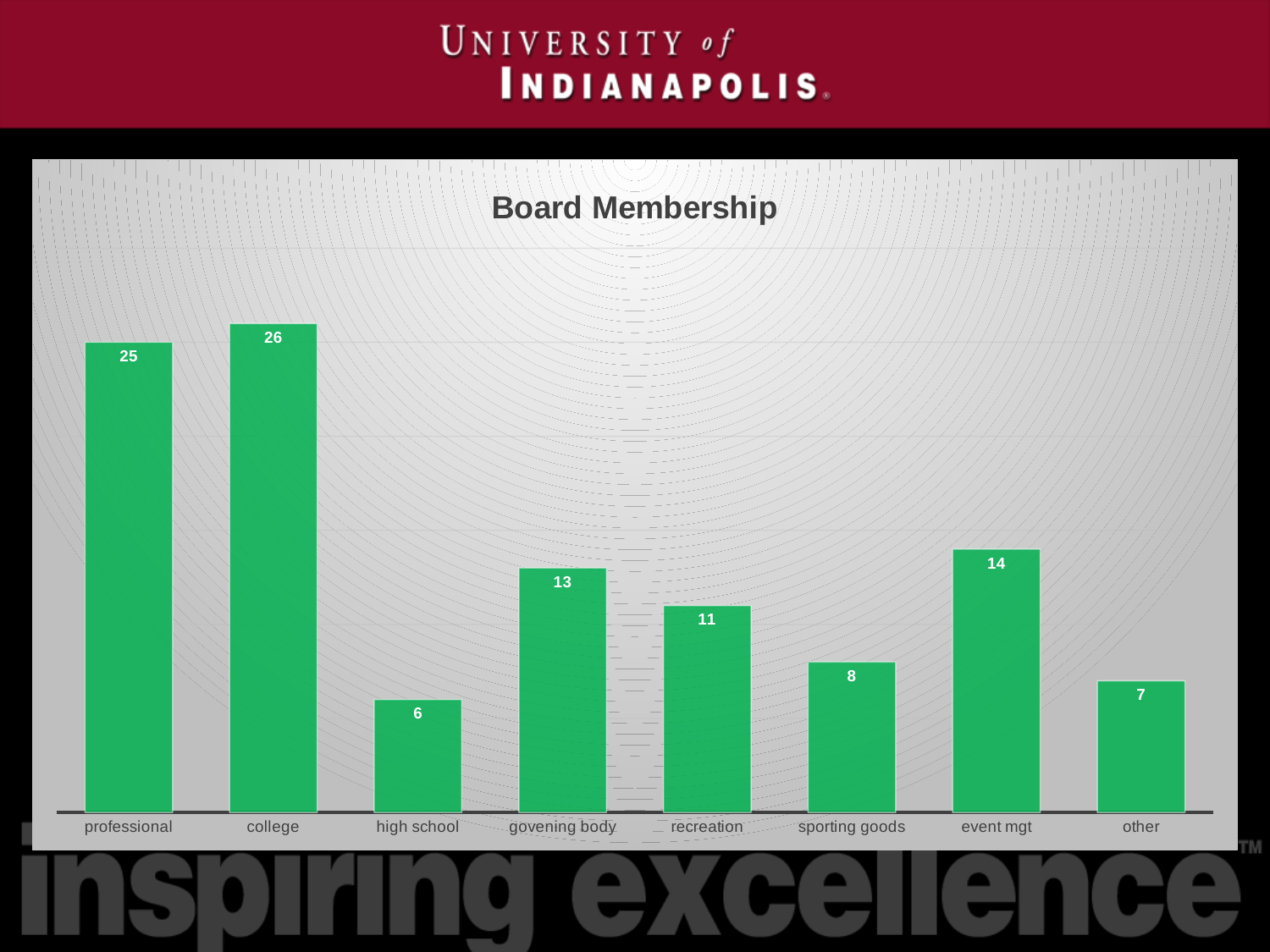
What colour are the bars in the Board Membership chart? green What kind of chart is the Board Membership chart? bar chart Which category has the lowest value in the Board Membership chart? high school Which is larger in the Board Membership chart, govening body or sporting goods? govening body What is the title of the chart on the slide? Board Membership What is the value for high school in the Board Membership chart? 6 What is the difference between the values for event mgt and other in the Board Membership chart? 7 Which category has the highest value in the Board Membership chart? college How many categories are shown in the Board Membership chart? 8 What is the difference between the values for professional and recreation in the Board Membership chart? 14 What is the value for college in the Board Membership chart? 26 What is the value for event mgt in the Board Membership chart? 14